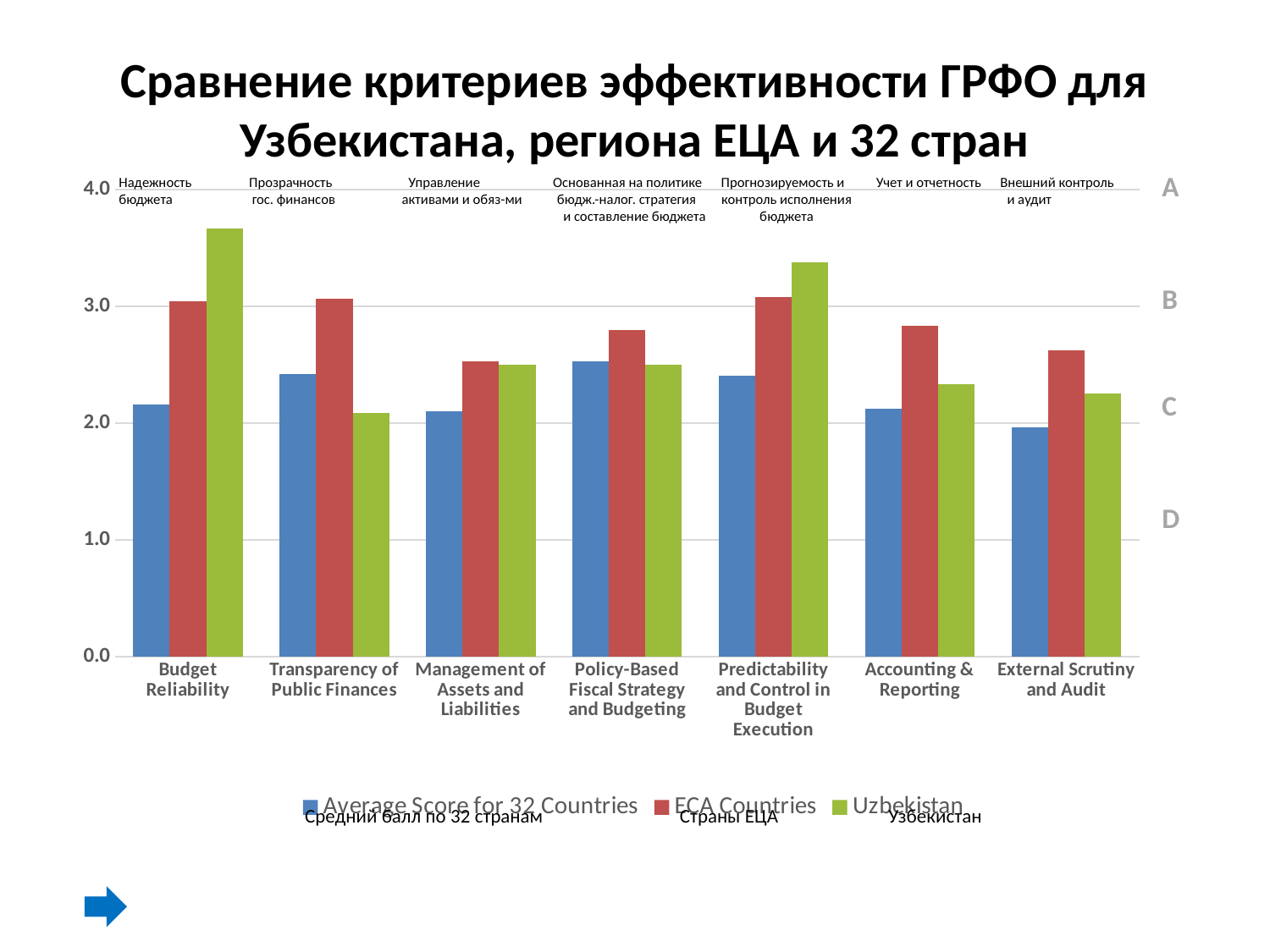
For which category is the Uzbekistan value lowest? Transparency of Public Finances How many series does the legend list? 3 For which category is the Uzbekistan value highest? Budget Reliability Which series is shown in green in the legend? Uzbekistan What type of chart is shown on the slide? bar chart How many categories are shown along the x axis? 7 For Transparency of Public Finances, which is larger: the ECA Countries value or the Uzbekistan value? ECA Countries Is the Uzbekistan value for Predictability and Control in Budget Execution greater or less than 3.0? greater For Budget Reliability, which is larger: the ECA Countries value or the Uzbekistan value? Uzbekistan For Accounting & Reporting, which is larger: the Average Score for 32 Countries value or the ECA Countries value? ECA Countries Is the Uzbekistan value for Budget Reliability greater or less than 3.0? greater Is the Average Score for 32 Countries value for Budget Reliability greater or less than 2.0? greater